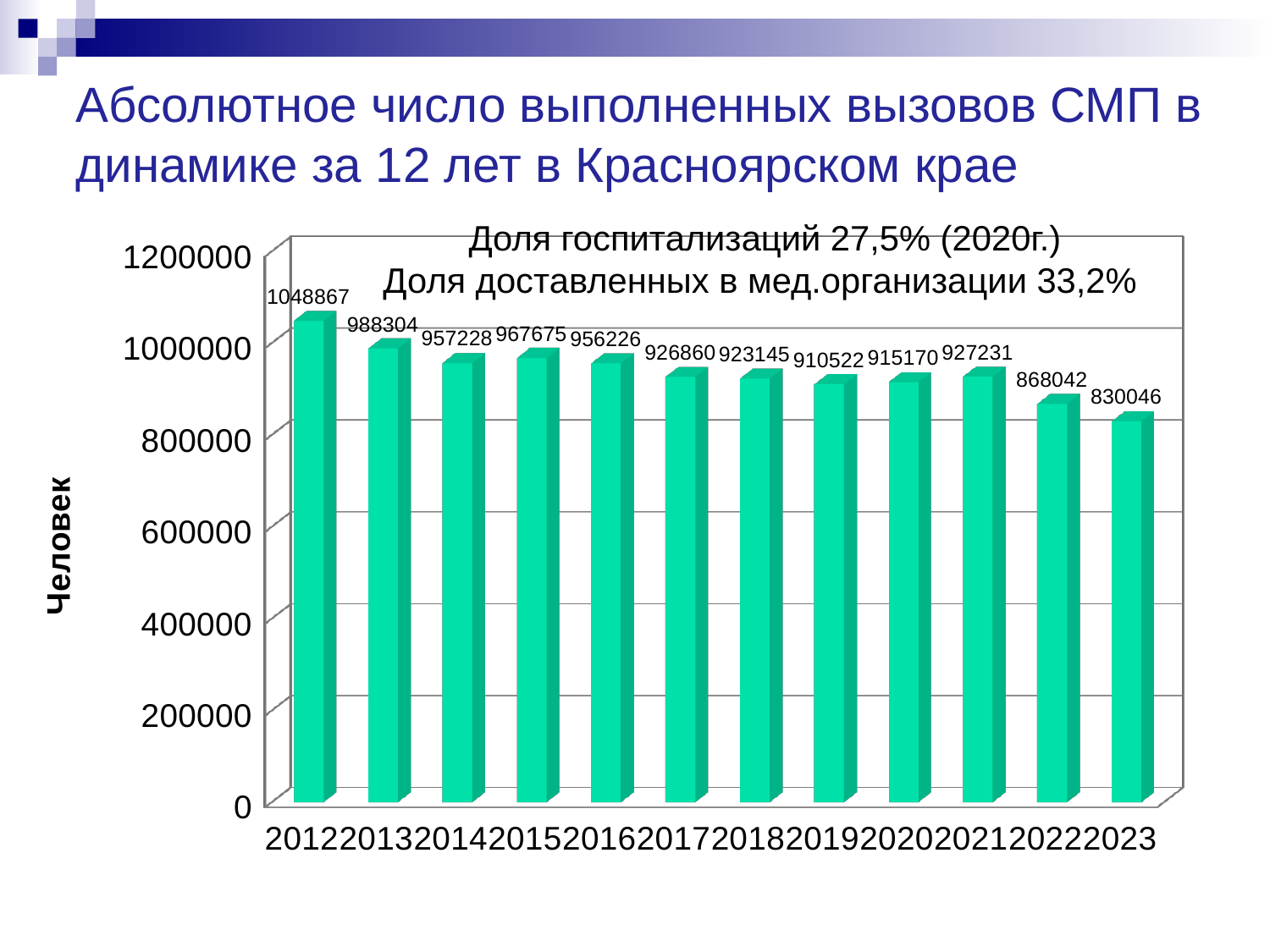
What is the value for 2012? 1048867 How many years are shown on the x axis? 12 Which is larger, the value for 2015 or the value for 2014? 2015 What is the difference between the values for 2022 and 2023? 37996 What is the value for 2023? 830046 What is the label of the vertical axis? Человек Is the value for 2022 greater or less than 1000000? less What is the difference between the values for 2012 and 2023? 218821 Which year has the highest value? 2012 Which year has the lowest value? 2023 What kind of chart is shown on the slide? bar chart What is the value for 2018? 923145